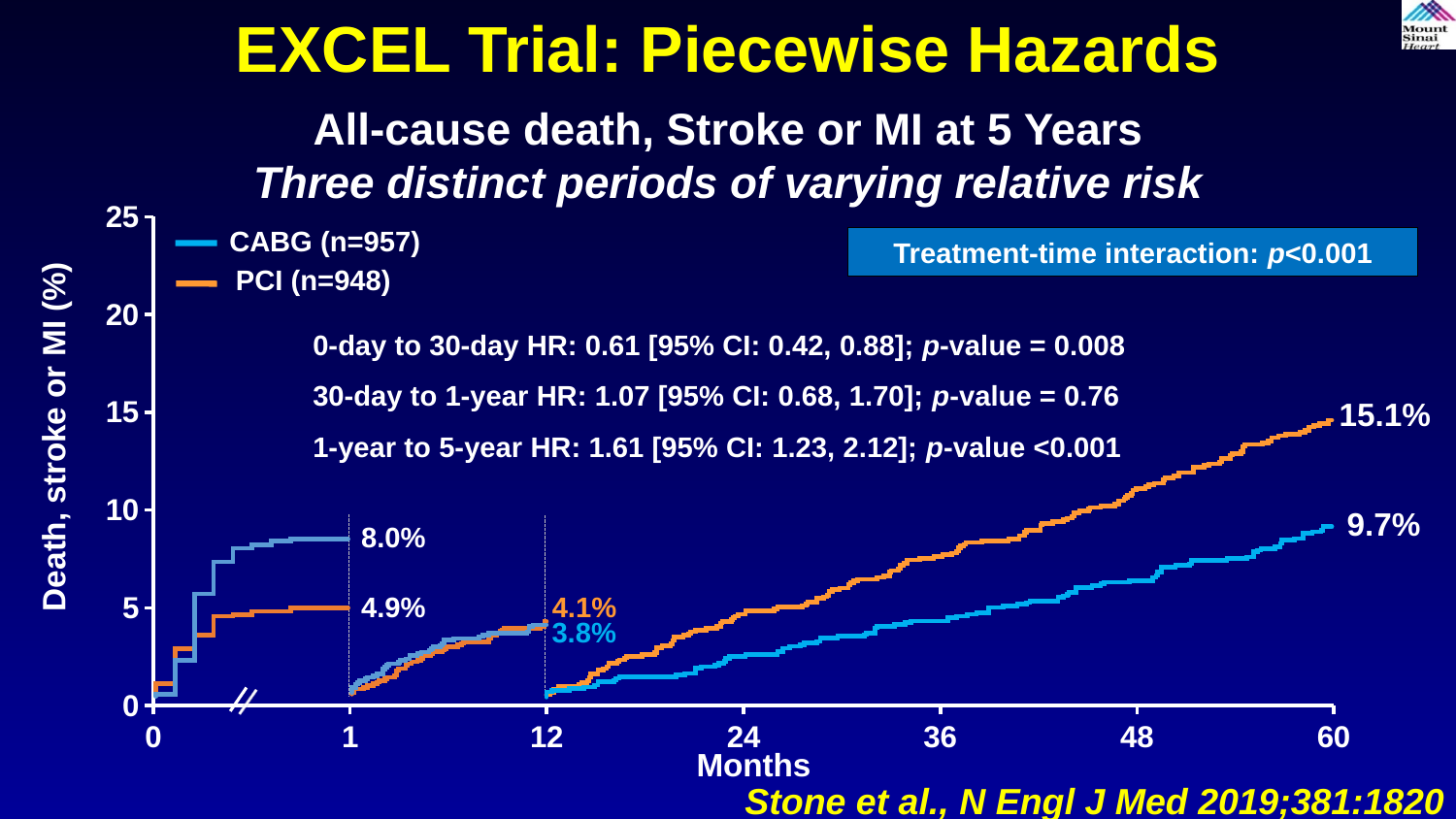
What is the value for CABG at 60 months? 9.7% Is the value for PCI at 60 months greater or less than 15? greater What is the label of the y axis? Death, stroke or MI (%) How many series does the legend list? 2 What kind of chart is shown on the slide? Line chart What is the value for PCI at 1 month? 4.9% What is the value for PCI at 60 months? 15.1% What is the value for CABG at 1 month? 8.0% What is the difference between the CABG and PCI values at 1 month? 3.1% Which series has the higher value at 1 month, CABG or PCI? CABG Which series has the higher value at 60 months, CABG or PCI? PCI What is the difference between the PCI and CABG values at 60 months? 5.4%